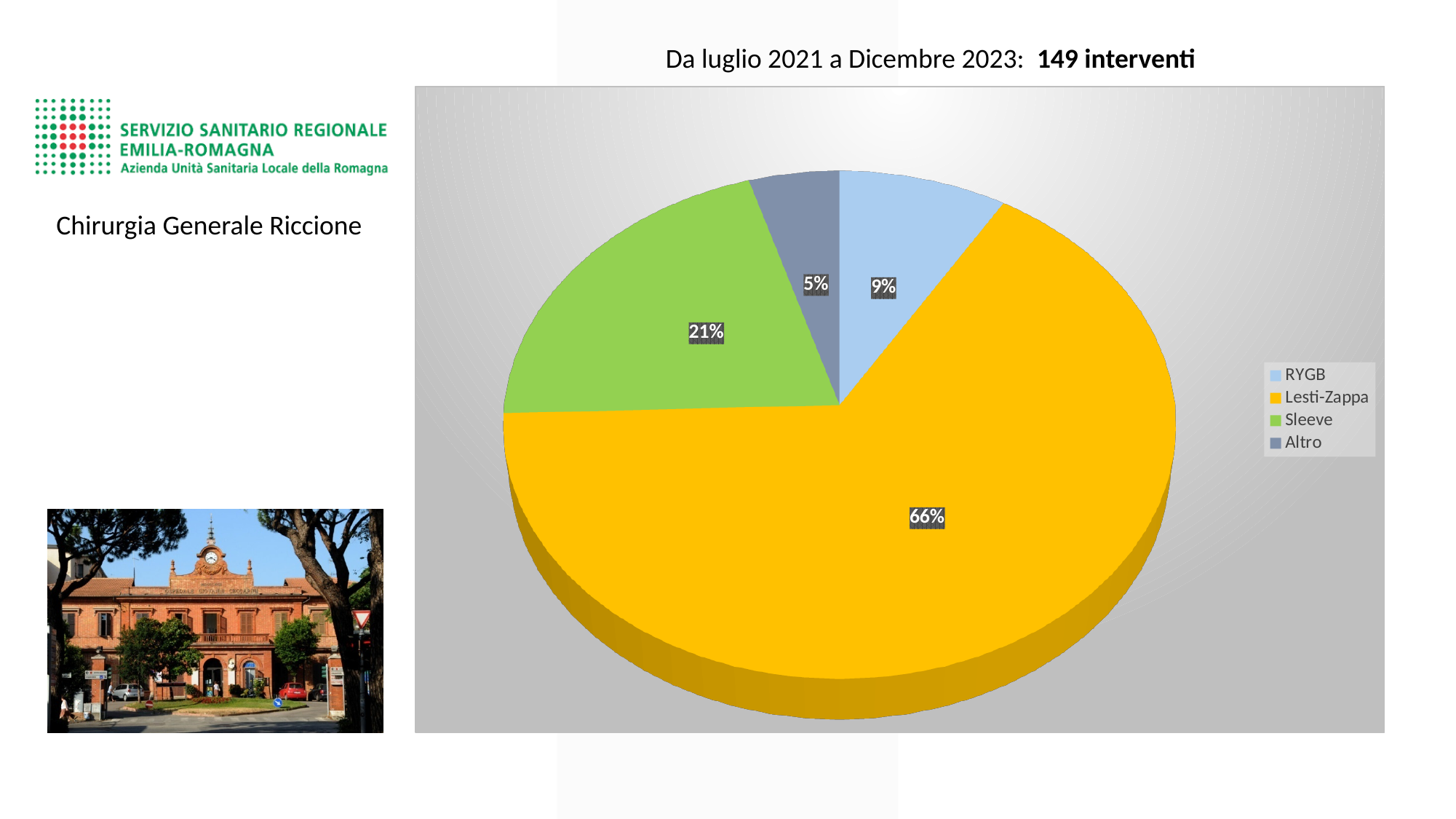
What kind of chart is shown on the slide? pie chart What share of the pie does Altro account for? 5% What share of the pie does Sleeve account for? 21% Which category has the smallest slice of the pie? Altro What colour is the Sleeve slice? green Which slice is larger, Sleeve or RYGB? Sleeve What share of the pie does Lesti-Zappa account for? 66% Which category has the largest slice of the pie? Lesti-Zappa What is the difference in percentage points between the Lesti-Zappa and Sleeve slices? 45 How many categories does the legend list? 4 How many interventions does the chart title say were performed from July 2021 to December 2023? 149